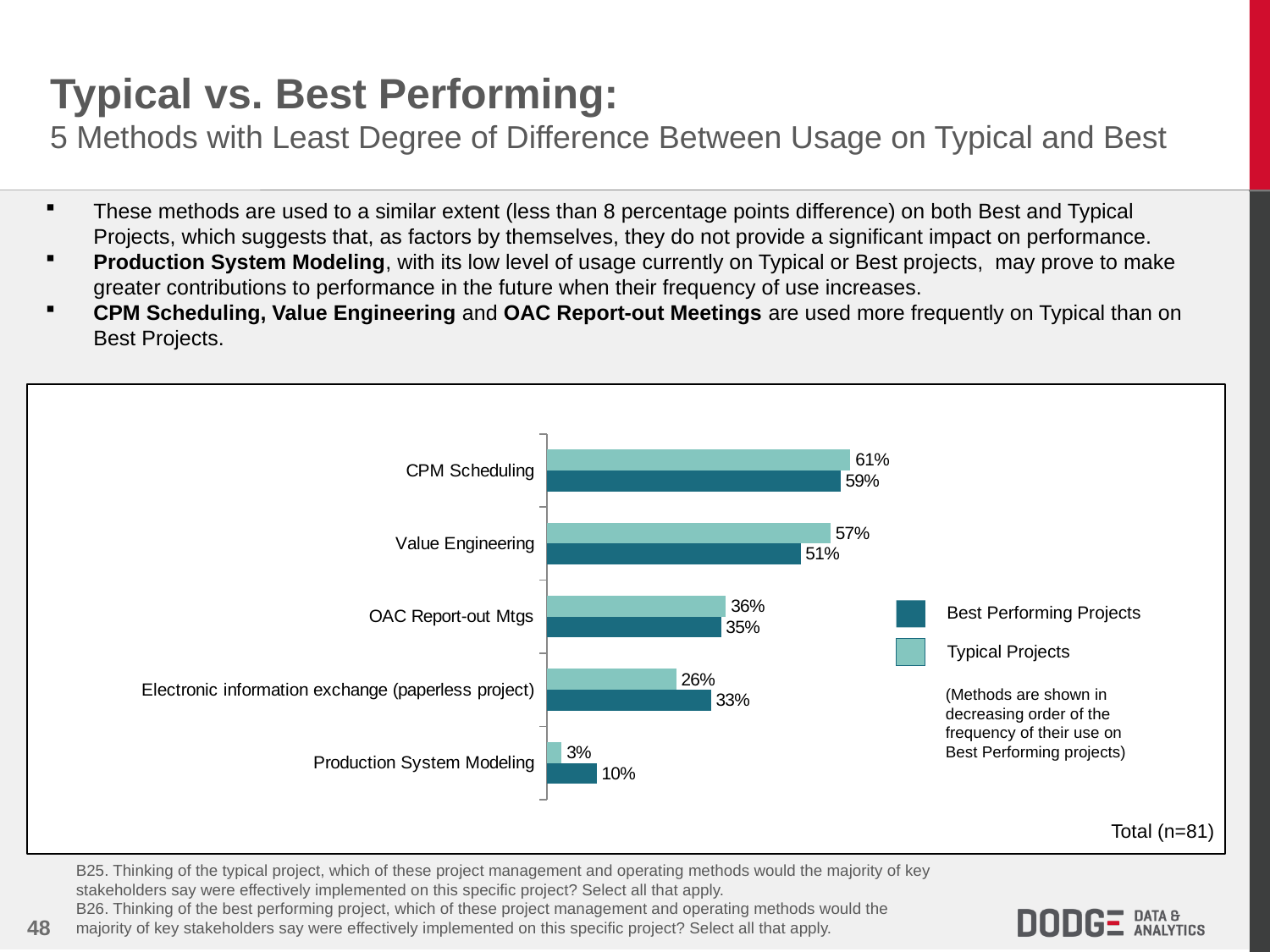
What kind of chart is shown on the slide? Bar chart What is the value for Best Performing Projects for Production System Modeling? 10% What is the value for Typical Projects for CPM Scheduling? 61% For Electronic information exchange (paperless project), which is larger: the Best Performing Projects value or the Typical Projects value? Best Performing Projects How many methods are shown on the chart? 5 How many series does the legend list? 2 What is the value for Typical Projects for Electronic information exchange (paperless project)? 26% What is the difference between the Typical Projects and Best Performing Projects values for Value Engineering? 6% What is the difference between the Best Performing Projects and Typical Projects values for Production System Modeling? 7% Which method has the highest value for Best Performing Projects? CPM Scheduling What is the value for Best Performing Projects for Value Engineering? 51% Which method has the lowest value for Typical Projects? Production System Modeling